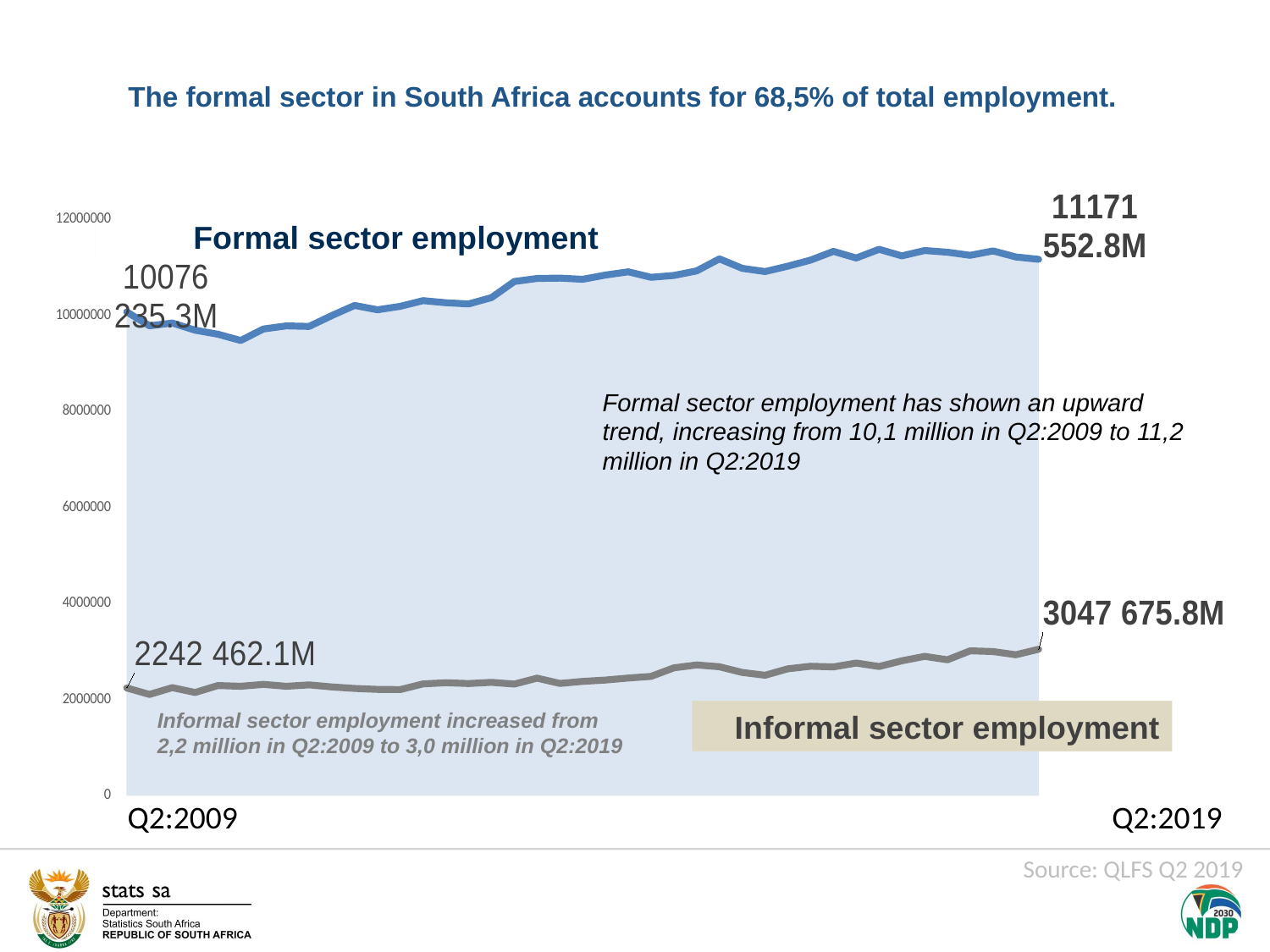
By how much did informal sector employment increase from Q2:2009 (2242 462.1M) to Q2:2019 (3047 675.8M)? 805 213.8M What colour is the formal sector employment line? blue What is the formal sector employment value labelled at Q2:2019? 11171 552.8M What is the formal sector employment value labelled at Q2:2009? 10076 235.3M What is the informal sector employment value labelled at Q2:2009? 2242 462.1M What kind of chart is shown on the slide? line chart How many data series are plotted on the chart? 2 Does informal sector employment rise or fall from Q2:2009 to Q2:2019? rise Is the formal sector employment value at Q2:2019 greater or less than 10000000? greater Which series has the higher value at Q2:2019, formal sector employment or informal sector employment? Formal sector employment Is the informal sector employment value at Q2:2019 greater or less than 4000000? less What is the informal sector employment value labelled at Q2:2019? 3047 675.8M